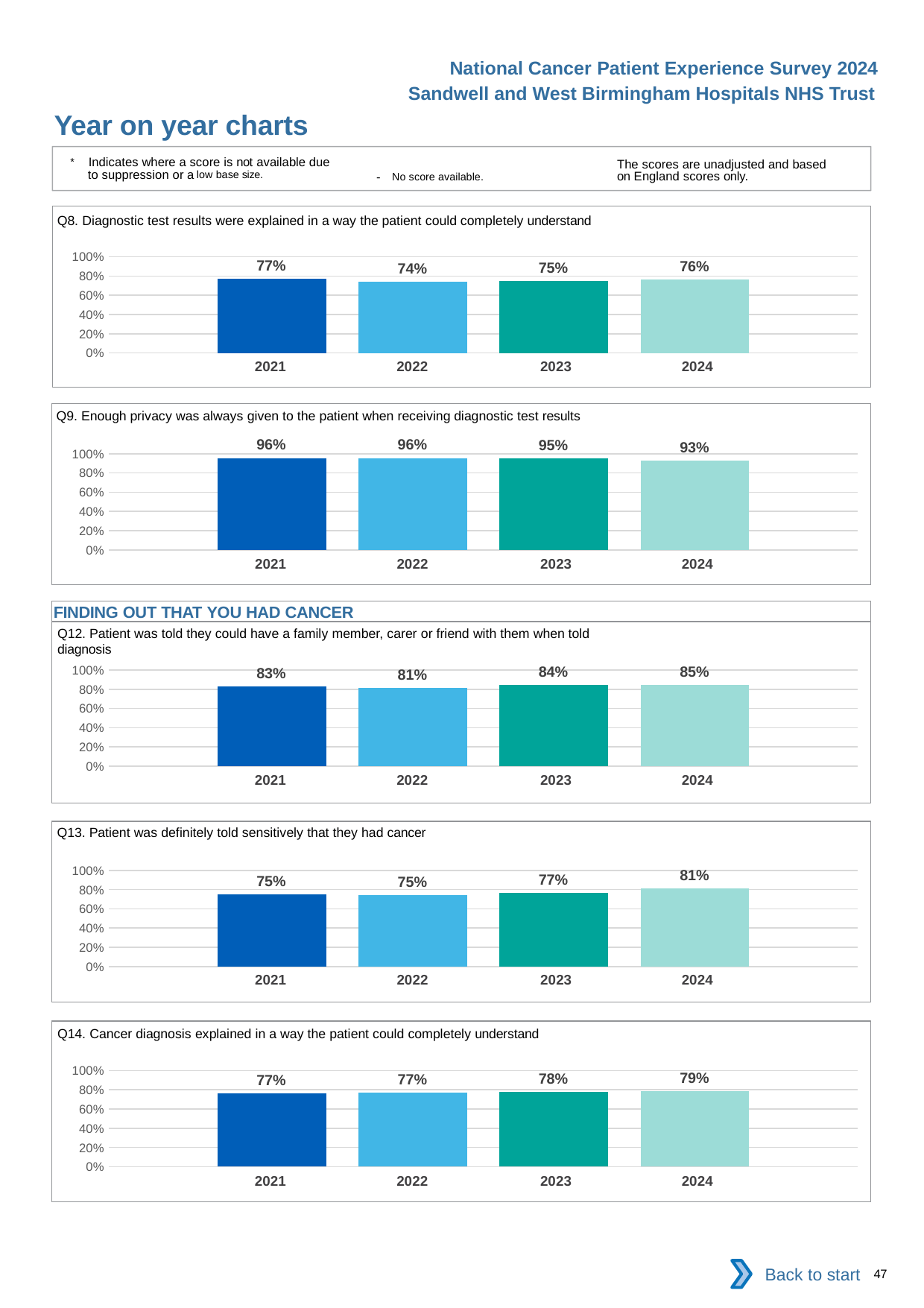
In the Q13 chart (Patient was definitely told sensitively that they had cancer), what is the value for 2024? 81% In the Q12 chart (Patient was told they could have a family member, carer or friend with them when told diagnosis), which year has the highest value? 2024 In the Q8 chart, which year has the lowest value? 2022 In the Q12 chart, what is the value for 2022? 81% In the Q9 chart (Enough privacy was always given to the patient when receiving diagnostic test results), what is the value for 2024? 93% In the Q8 chart (Diagnostic test results were explained in a way the patient could completely understand), what is the value for 2021? 77% In the Q14 chart, which is larger, the value for 2023 or the value for 2024? 2024 In the Q13 chart, what is the difference between the 2024 value and the 2021 value? 6% In the Q9 chart, what is the difference between the 2021 value and the 2024 value? 3% In the Q14 chart (Cancer diagnosis explained in a way the patient could completely understand), do the values rise or fall from 2021 to 2024? rise What kind of chart is the Q9 chart? bar chart How many years are shown in the Q13 chart? 4